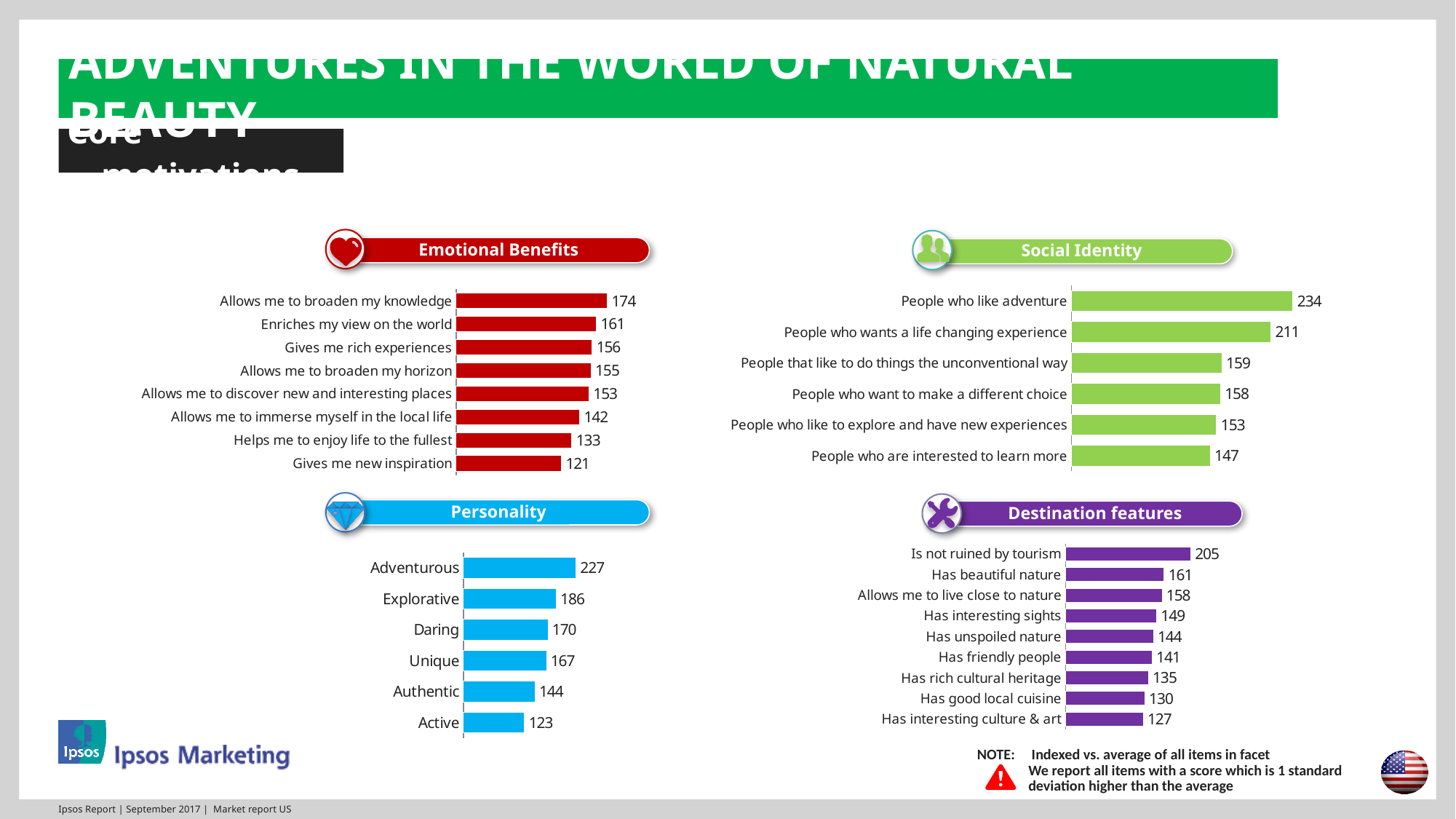
How many categories are shown in the Destination features chart? 9 In the Social Identity chart, which category has the highest value? People who like adventure In the Emotional Benefits chart, which category has the lowest value? Gives me new inspiration In the Personality chart, which is larger, "Explorative" or "Unique"? Explorative In the Personality chart, what is the value for "Daring"? 170 In the Social Identity chart, what is the value for "People who wants a life changing experience"? 211 In the Destination features chart, what is the value for "Has unspoiled nature"? 144 In the Emotional Benefits chart, what is the value for "Allows me to broaden my knowledge"? 174 In the Emotional Benefits chart, what is the difference between "Enriches my view on the world" and "Helps me to enjoy life to the fullest"? 28 How many categories are shown in the Social Identity chart? 6 What type of chart is the Destination features chart? Bar chart In the Personality chart, what is the difference between "Adventurous" and "Active"? 104